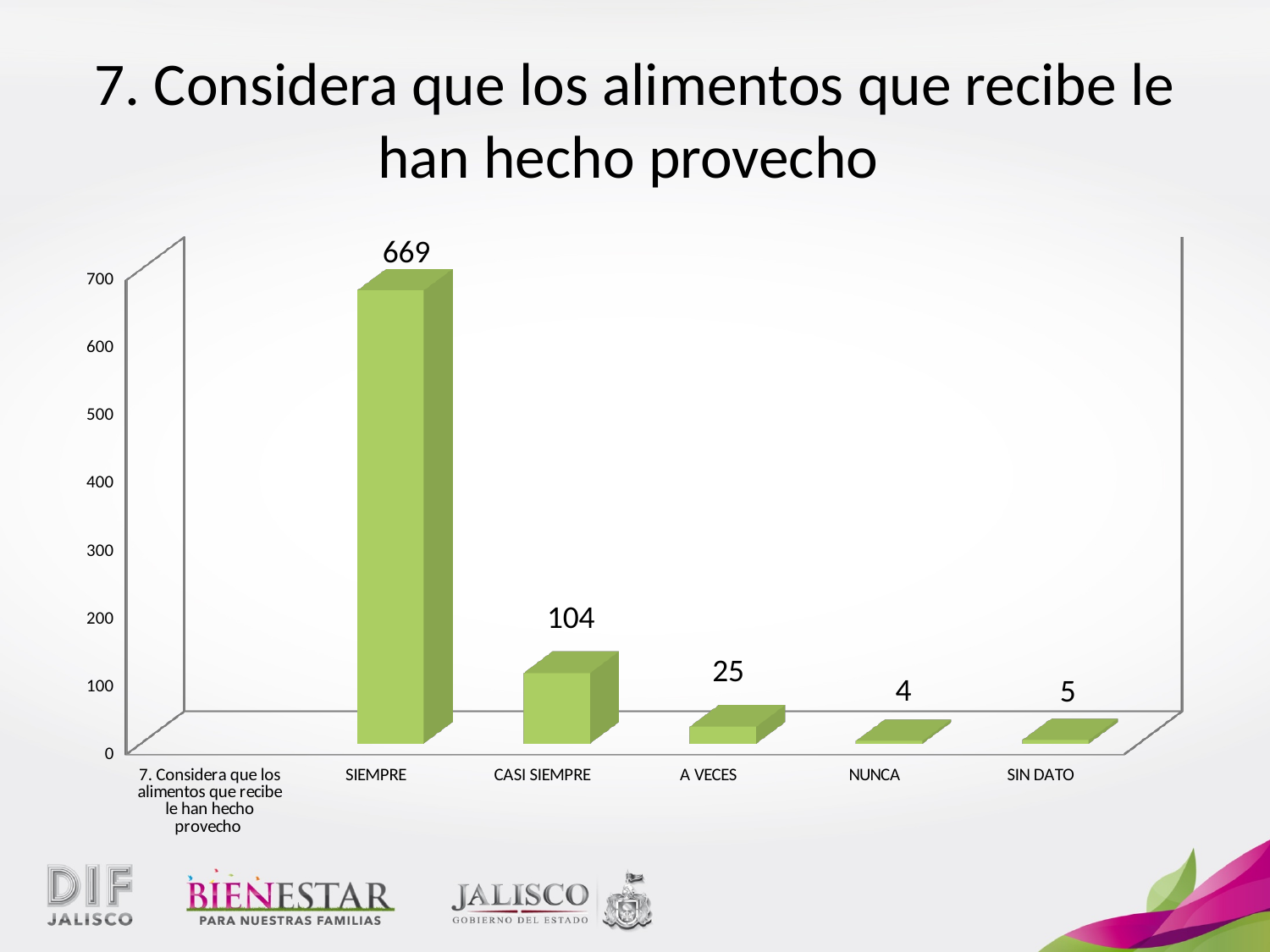
What kind of chart is shown on the slide? bar chart What is the value for A VECES? 25 How many bars are plotted in the chart? 5 Which is larger, the value for NUNCA or the value for SIN DATO? SIN DATO What is the value for CASI SIEMPRE? 104 What is the value for NUNCA? 4 Which category has the highest value? SIEMPRE What is the difference between the values for SIEMPRE and CASI SIEMPRE? 565 Is the value for CASI SIEMPRE greater or less than 200? less Which category has the lowest value? NUNCA What is the value for SIN DATO? 5 What is the value for SIEMPRE? 669